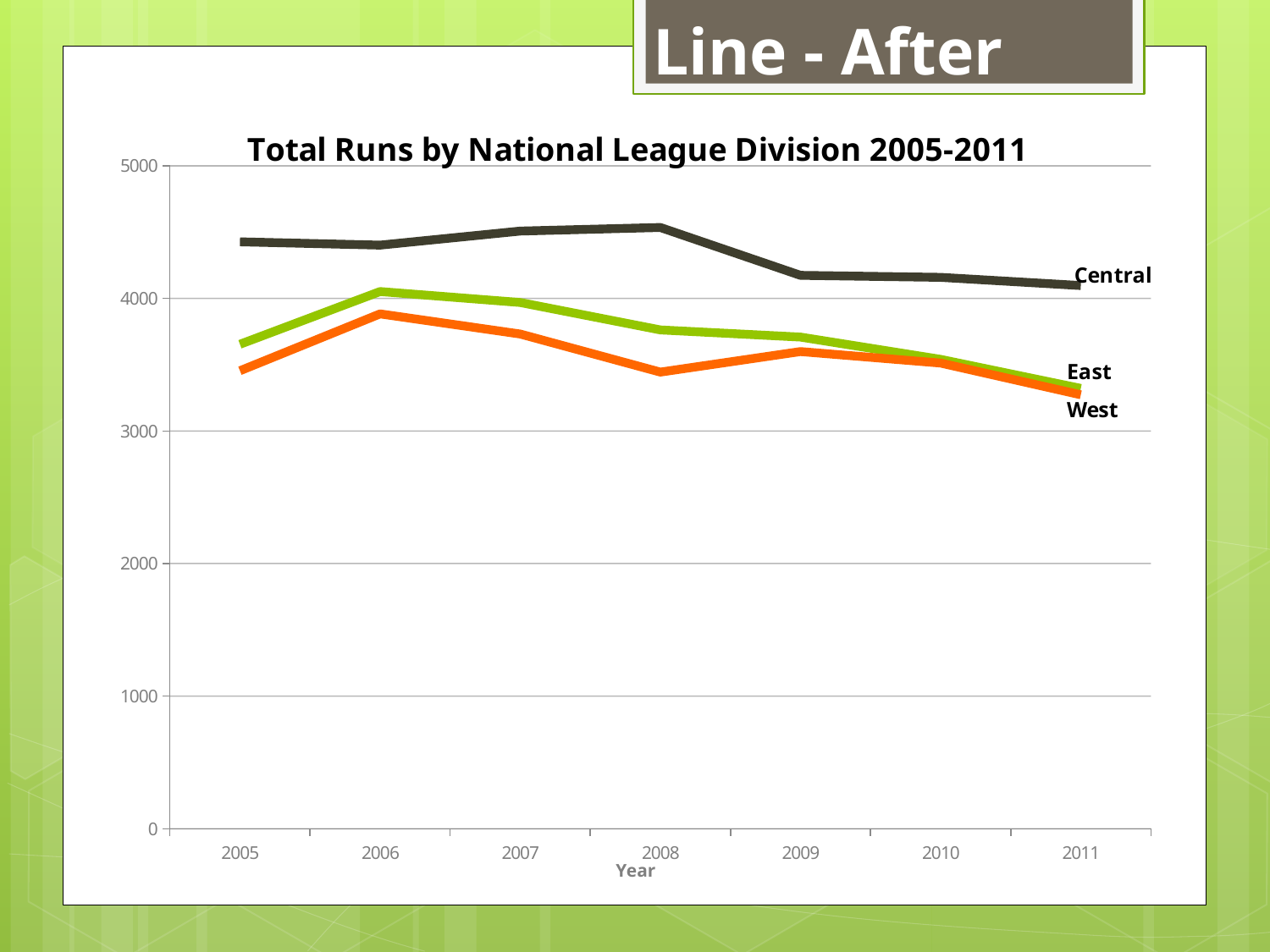
What kind of chart is shown on the slide? line chart In which year does East reach its highest value? 2006 Is the value for West in 2008 greater or less than 4000? less Is the value for East in 2011 greater or less than 3000? greater Is the value for Central in 2005 greater or less than 4000? greater What is the title of the chart? Total Runs by National League Division 2005-2011 Which is larger in 2005, the value for East or the value for West? East Do the values for Central rise or fall from 2008 to 2011? fall Which division has the highest total runs in 2009? Central How many years are shown along the x axis? 7 Which division has the lowest total runs in 2005? West How many series (divisions) are plotted on the chart? 3